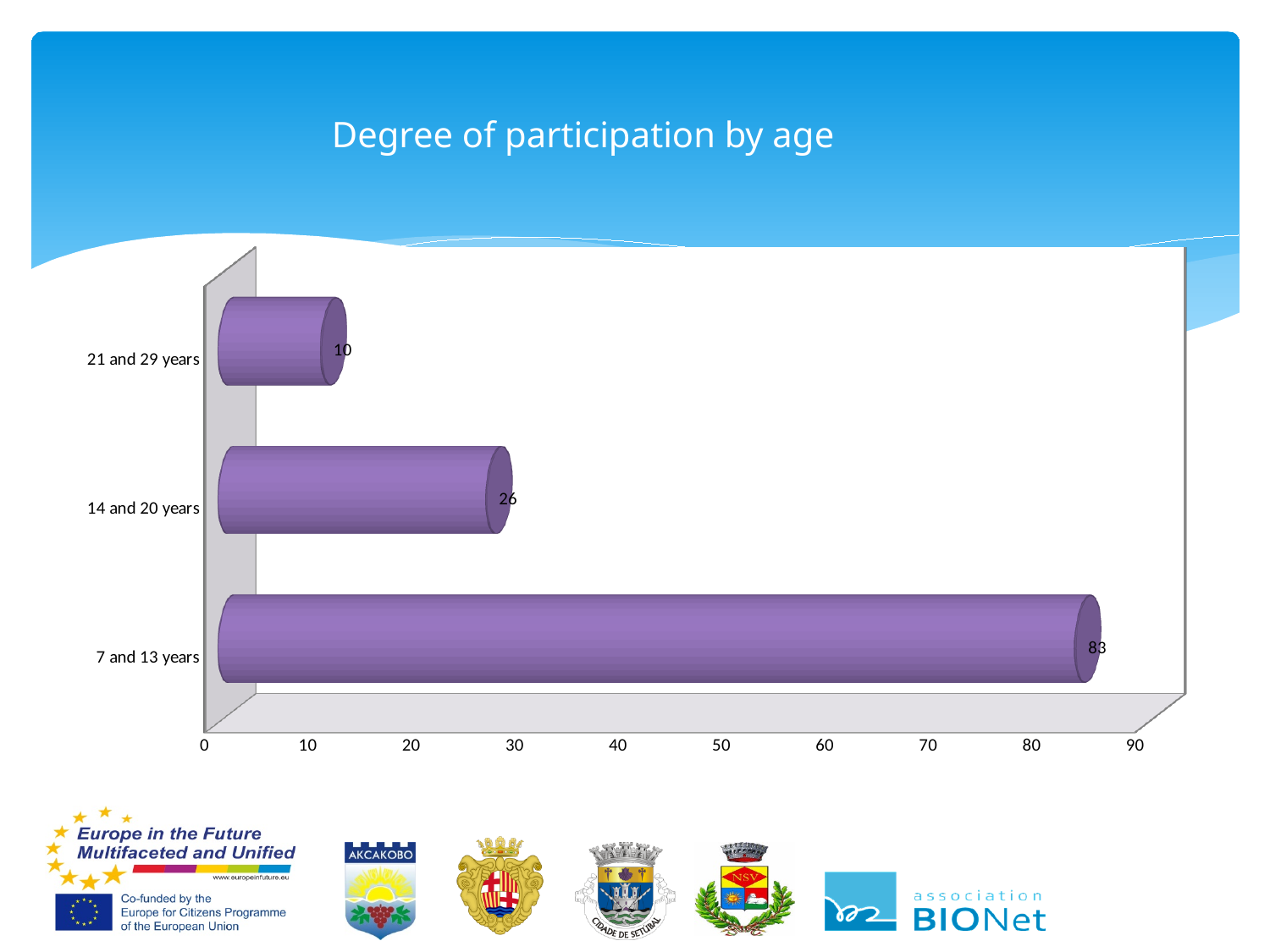
What kind of chart is shown on the slide? bar chart What is the title of the chart? Degree of participation by age What is the value for 14 and 20 years? 26 What is the value for 21 and 29 years? 10 Which is larger, the value for 14 and 20 years or the value for 21 and 29 years? 14 and 20 years How many age groups are shown in the chart? 3 What is the difference between the values for 7 and 13 years and 14 and 20 years? 57 What is the difference between the values for 14 and 20 years and 21 and 29 years? 16 What is the value for 7 and 13 years? 83 Which age group has the lowest value? 21 and 29 years Is the value for 7 and 13 years greater or less than 80? greater Which age group has the highest value? 7 and 13 years